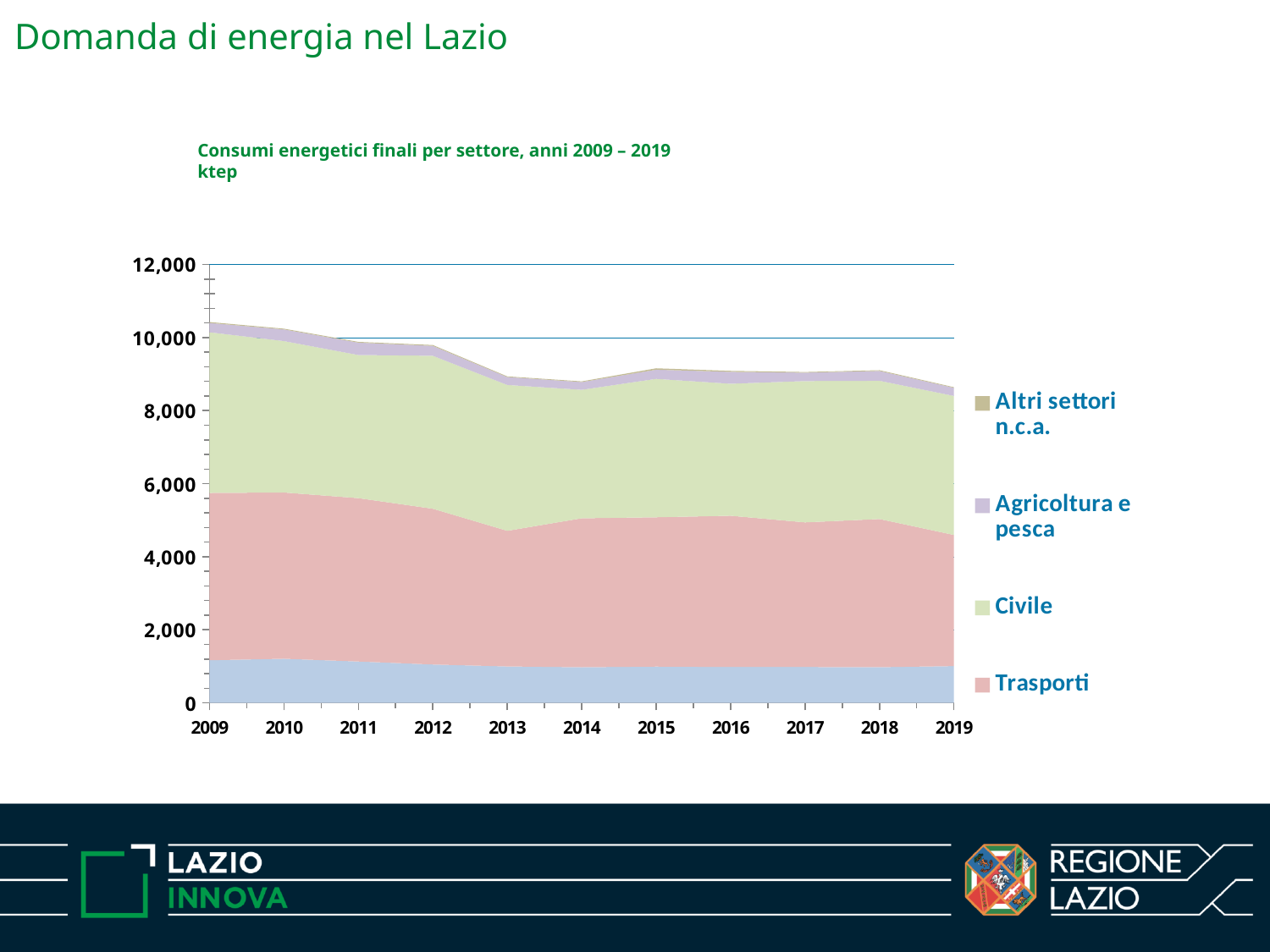
Is the total energy consumption in 2019 greater or less than 10,000? less Is the total energy consumption in 2019 greater or less than 8,000? greater How many years are shown along the x axis? 11 Which year has the highest total energy consumption? 2009 Which is larger, the total energy consumption in 2009 or in 2019? 2009 Is the total energy consumption in 2013 greater or less than 10,000? less How many series does the legend list? 4 What kind of chart is shown on the slide? Stacked area chart What unit of measurement is stated for the chart? ktep Does the total energy consumption rise or fall from 2009 to 2019? Fall What is the title of the chart? Consumi energetici finali per settore, anni 2009 – 2019